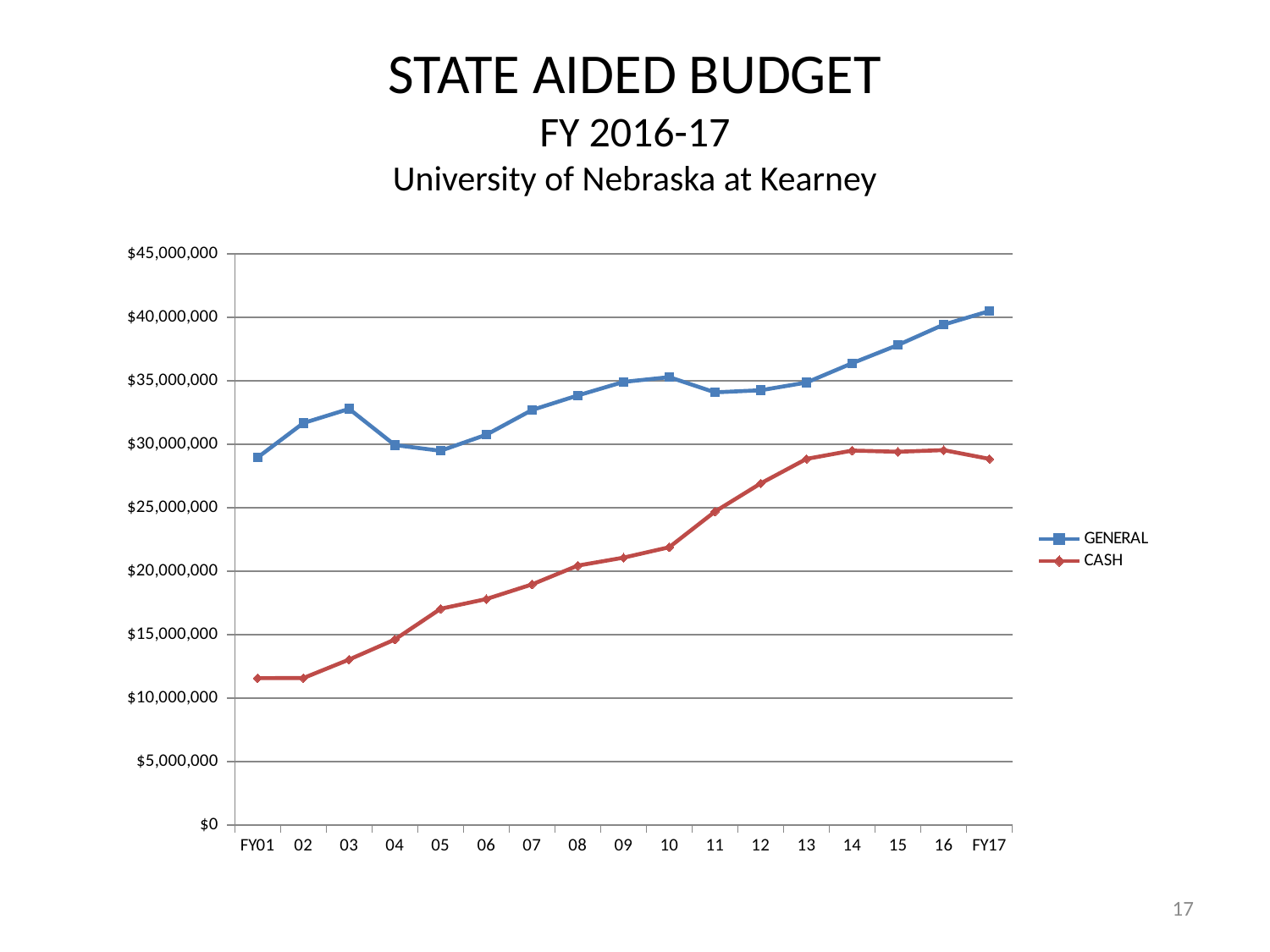
How many fiscal years are plotted along the x axis? 17 Which series is drawn in red? CASH In which fiscal year is the GENERAL series at its highest? FY17 Is the GENERAL value for FY01 greater or less than $30,000,000? less How many series does the legend list? 2 Does the CASH series generally rise or fall from FY01 to FY14? rise What is the main title of the chart slide? STATE AIDED BUDGET What kind of chart is shown on the slide? line chart Is the CASH value for FY05 greater or less than $15,000,000? greater Is the CASH value for FY17 greater or less than $30,000,000? less Which series has the larger value in FY10, GENERAL or CASH? GENERAL